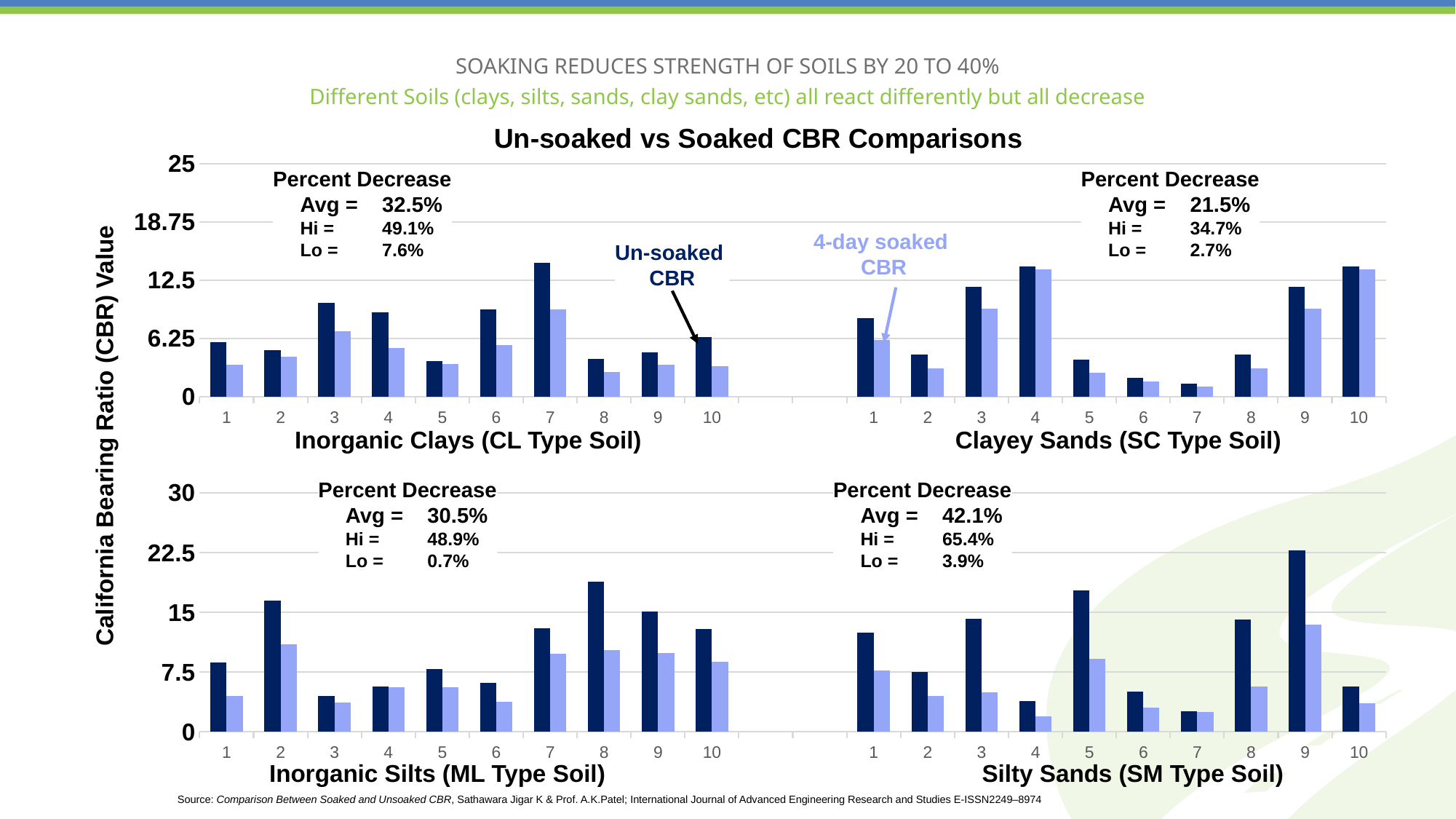
How many series are shown in each chart (Un-soaked CBR and 4-day soaked CBR)? 2 In the Inorganic Silts (ML Type Soil) chart, which sample has the highest Un-soaked CBR value? 8 How many soil samples are plotted on the x axis of the Inorganic Clays (CL Type Soil) chart? 10 In the Clayey Sands (SC Type Soil) chart, which sample has the lowest Un-soaked CBR value? 7 In the Inorganic Silts (ML Type Soil) chart, which has the larger Un-soaked CBR value, sample 2 or sample 3? sample 2 What is the average percent decrease shown for the Silty Sands (SM Type Soil) chart? 42.1% In the Inorganic Clays (CL Type Soil) chart, which sample has the highest Un-soaked CBR value? 7 In the Silty Sands (SM Type Soil) chart, is the Un-soaked CBR value for sample 9 greater or less than 15? greater What is the overall title of the chart group on the slide? Un-soaked vs Soaked CBR Comparisons In the Silty Sands (SM Type Soil) chart, which sample has the highest Un-soaked CBR value? 9 In the Inorganic Clays (CL Type Soil) chart, is the Un-soaked CBR value for sample 7 greater or less than 12.5? greater What kind of chart is used for the Inorganic Clays (CL Type Soil) panel? bar chart